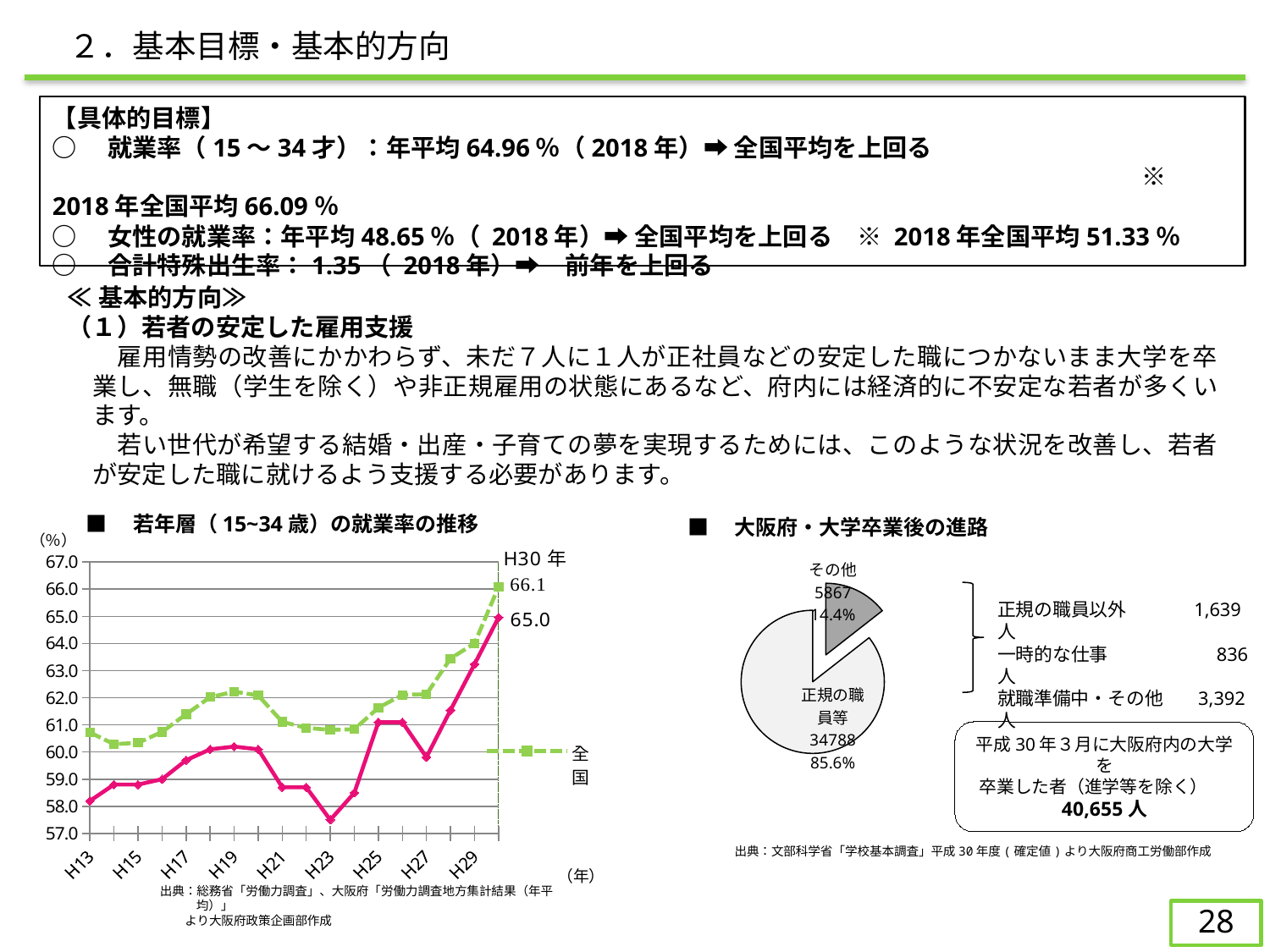
What kind of chart is 若年層（15~34歳）の就業率の推移? line chart In the line chart 若年層（15~34歳）の就業率の推移, what is the difference between the 全国 value and the solid pink line value in H30? 1.1 In the pie chart 大阪府・大学卒業後の進路, what is the value for 正規の職員等? 34788 How many slices does the pie chart 大阪府・大学卒業後の進路 have? 2 In the line chart 若年層（15~34歳）の就業率の推移, does the solid pink line rise or fall from H27 to H30? rise In the pie chart 大阪府・大学卒業後の進路, what share does その他 have? 14.4% In the line chart 若年層（15~34歳）の就業率の推移, what is the value of the solid pink line in H30? 65.0 In the line chart 若年層（15~34歳）の就業率の推移, is the value of the solid pink line in H23 greater or less than 58.0? less In the pie chart 大阪府・大学卒業後の進路, which slice is the largest? 正規の職員等 In the line chart 若年層（15~34歳）の就業率の推移, what is the value for 全国 in H30? 66.1 In the line chart 若年層（15~34歳）の就業率の推移, which is higher in H30, the 全国 line or the solid pink line? 全国 In the line chart 若年層（15~34歳）の就業率の推移, is the value for 全国 in H13 greater or less than 60.0? greater